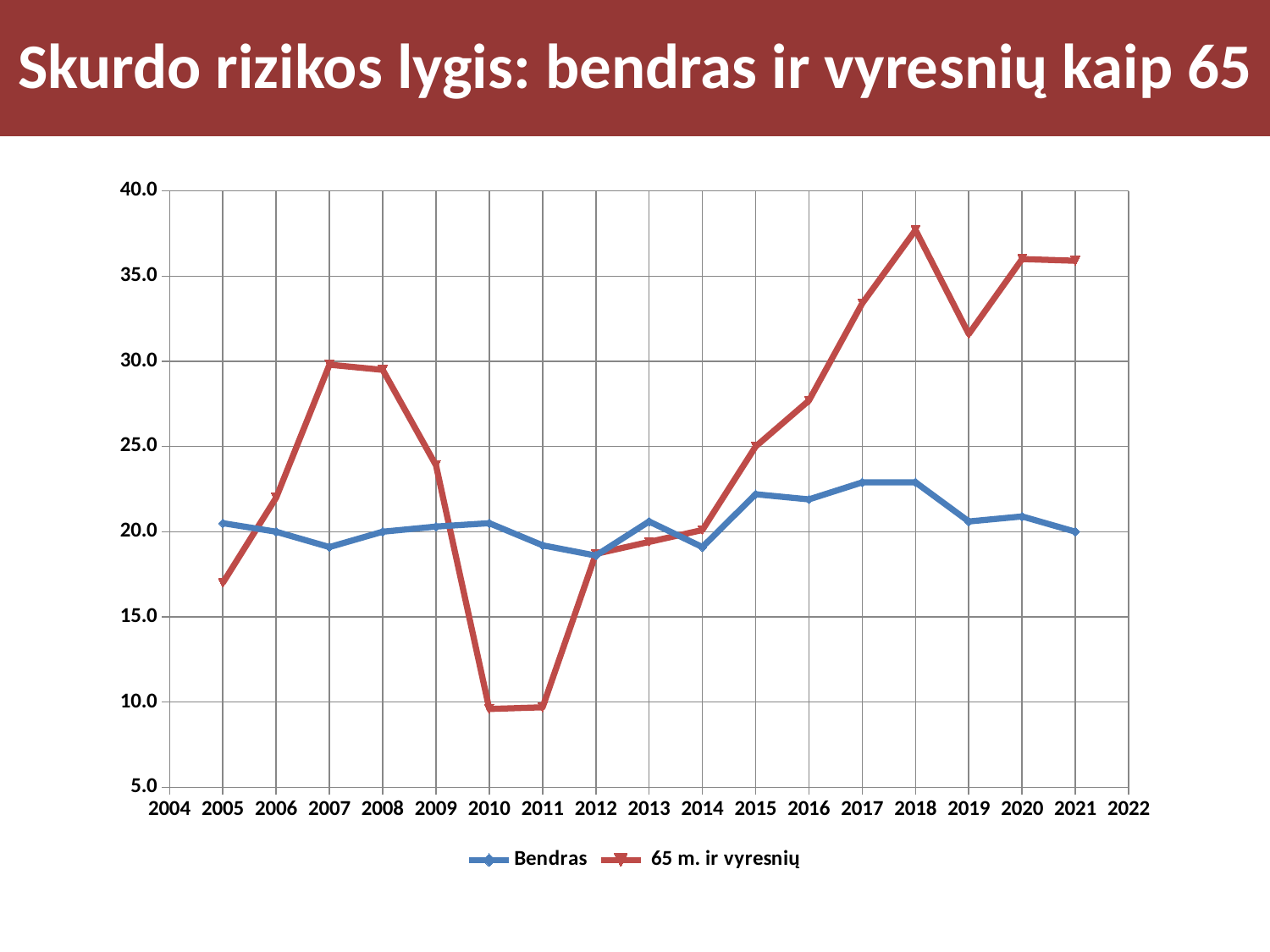
Does the 65 m. ir vyresnių series rise or fall from 2014 to 2018? rise In 2018, which series has the larger value, Bendras or 65 m. ir vyresnių? 65 m. ir vyresnių Is the value for 65 m. ir vyresnių in 2018 greater or less than 35? greater How many years have data points plotted for the Bendras series? 17 What colour is the line for the Bendras series? blue In 2010, which series has the larger value, Bendras or 65 m. ir vyresnių? Bendras Is the value for 65 m. ir vyresnių in 2010 greater or less than 10? less How many series does the legend list? 2 Is the value for 65 m. ir vyresnių in 2005 greater or less than 20? less In which year does the 65 m. ir vyresnių series reach its highest value? 2018 What kind of chart is shown on the slide? line chart